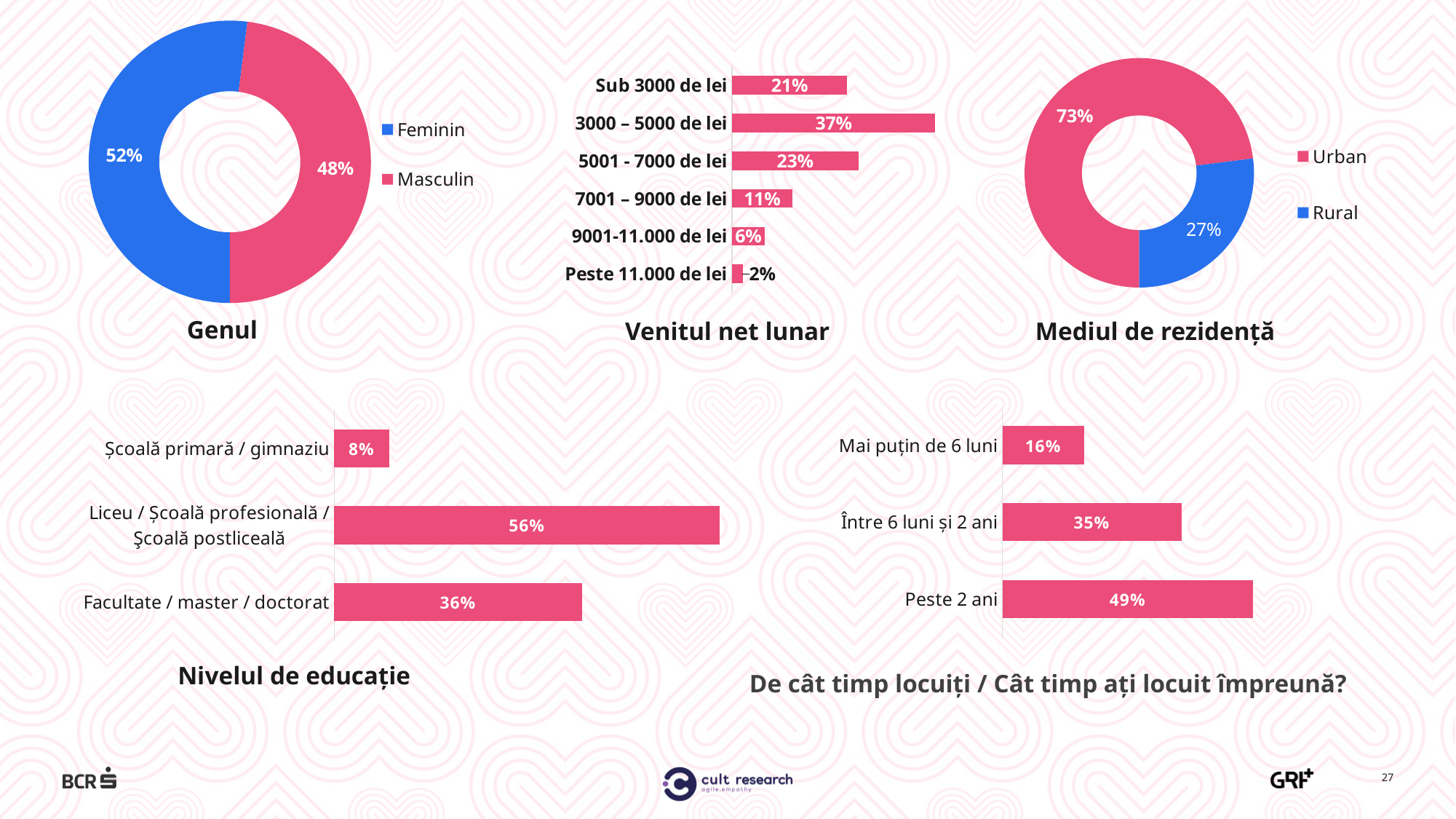
In the 'Venitul net lunar' chart, what is the value for '3000 – 5000 de lei'? 37% In the 'De cât timp locuiți / Cât timp ați locuit împreună?' chart, what is the value for 'Peste 2 ani'? 49% In the 'Mediul de rezidență' chart, what share is Rural? 27% In the 'Genul' chart, what share is Feminin? 52% In the 'Mediul de rezidență' chart, which is larger, Urban or Rural? Urban In the 'Nivelul de educație' chart, which category has the highest value? Liceu / Școală profesională / Școală postliceală In the 'Nivelul de educație' chart, what is the value for 'Facultate / master / doctorat'? 36% In the 'Venitul net lunar' chart, how many categories are shown? 6 In the 'Venitul net lunar' chart, which category has the lowest value? Peste 11.000 de lei In the 'Venitul net lunar' chart, what is the difference between 'Sub 3000 de lei' and '7001 – 9000 de lei'? 10% In the 'Genul' chart, what kind of chart is shown? Doughnut chart In the 'De cât timp locuiți / Cât timp ați locuit împreună?' chart, do the values rise or fall from top to bottom? Rise